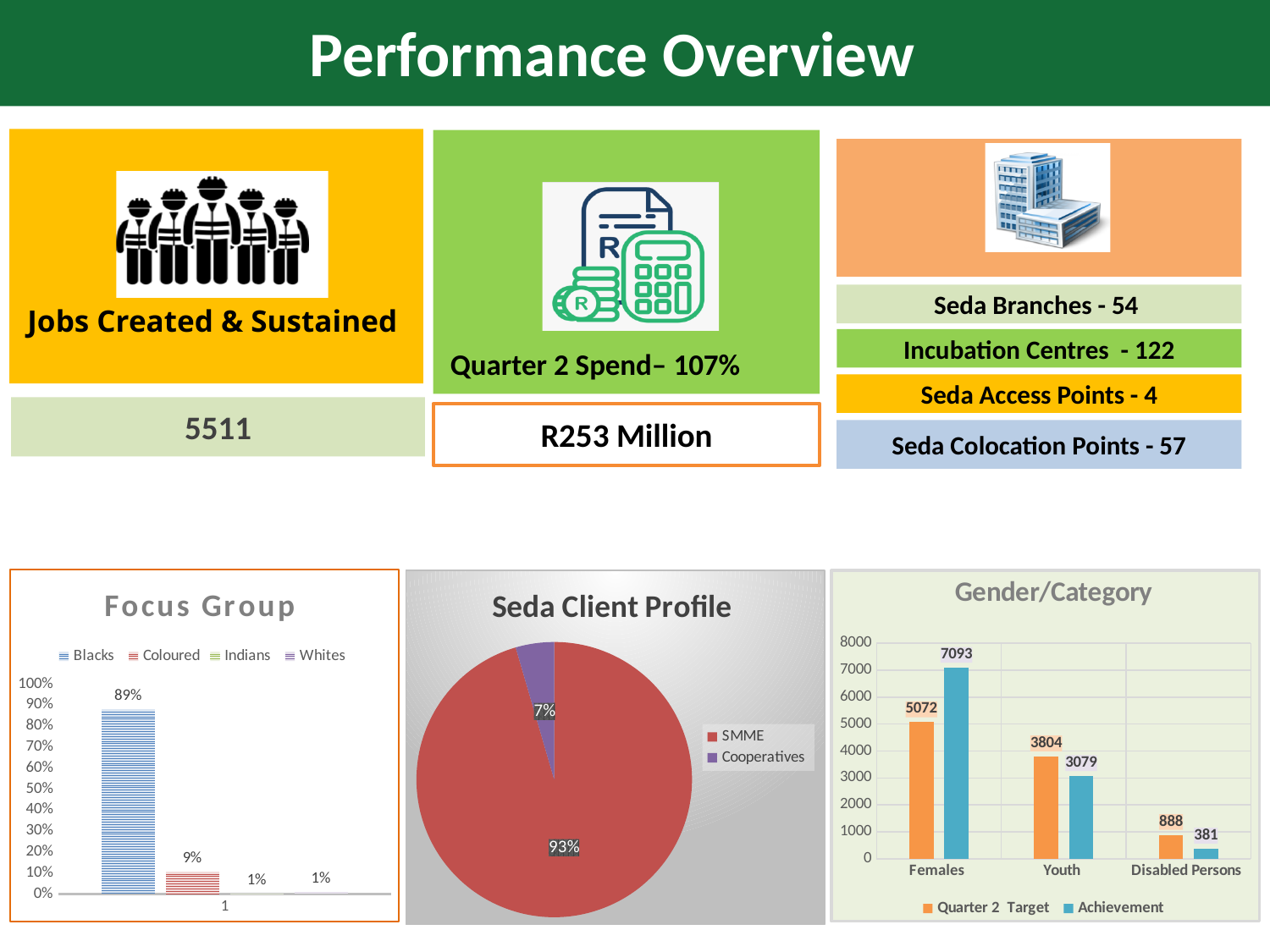
What kind of chart is the Seda Client Profile chart? Pie chart In the Gender/Category chart, which is larger for Youth: the Quarter 2 Target or the Achievement? Quarter 2 Target In the Focus Group chart, how many series does the legend list? 4 What kind of chart is the Gender/Category chart? Bar chart In the Gender/Category chart, what is the Achievement value for Females? 7093 In the Seda Client Profile chart, what share of the pie is SMME? 93% In the Focus Group chart, which group has the highest value? Blacks In the Gender/Category chart, what is the Quarter 2 Target for Youth? 3804 In the Seda Client Profile chart, what share of the pie is Cooperatives? 7% In the Focus Group chart, what is the value for Blacks? 89% In the Focus Group chart, what is the value for Coloured? 9% In the Gender/Category chart, what is the difference between the Quarter 2 Target and Achievement for Disabled Persons? 507